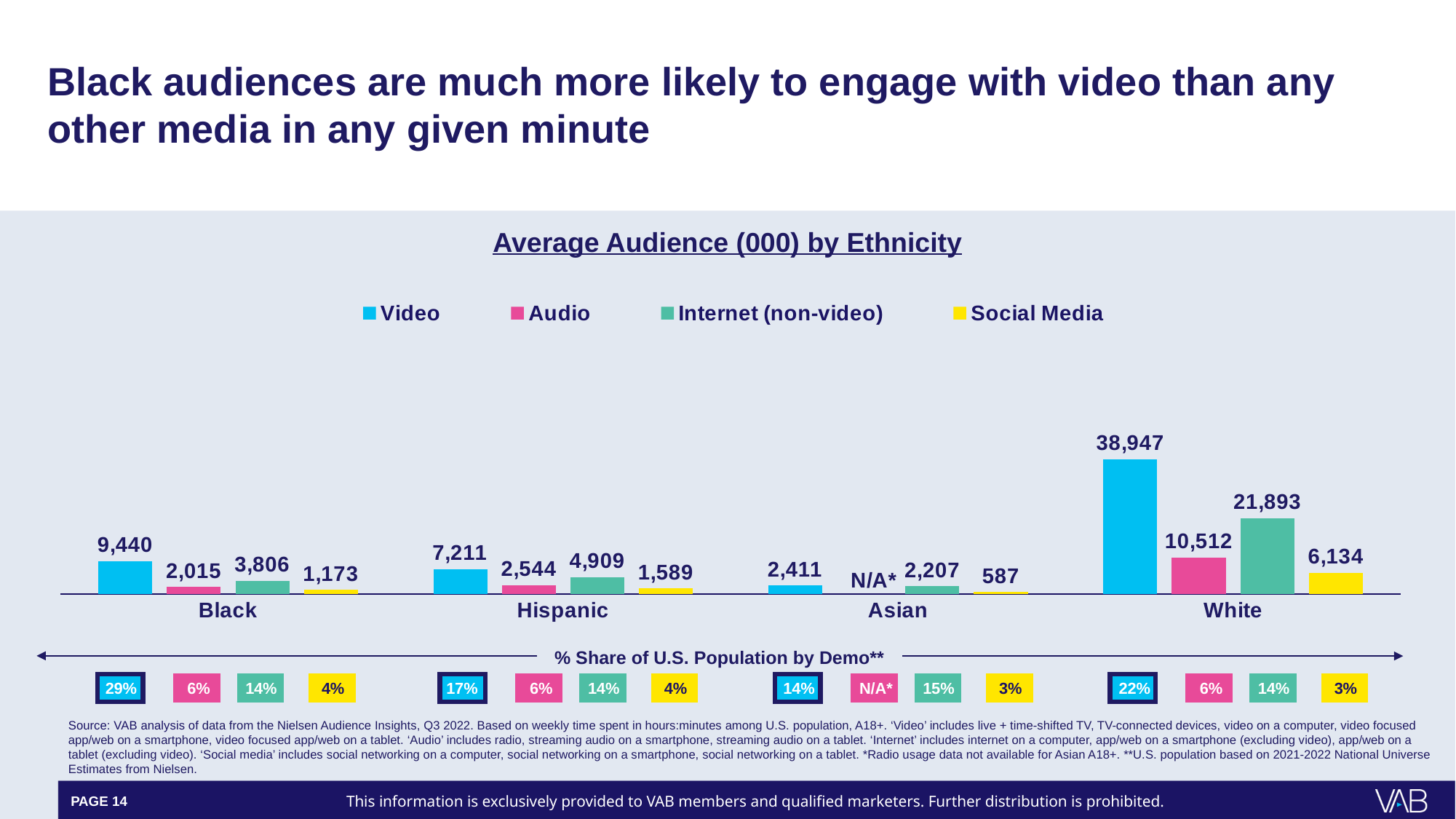
What is shown for the Audio value for Asian audiences? N/A* What is the Audio value for Hispanic audiences? 2,544 What is the Social Media value for Asian audiences? 587 Which ethnicity has the lowest Social Media value? Asian What type of chart is shown? Bar chart How many ethnicity categories are shown on the x axis? 4 How many series does the legend list? 4 What is the difference between the Video and Internet (non-video) values for White audiences? 17,054 What is the Video value for Black audiences? 9,440 What is the Internet (non-video) value for White audiences? 21,893 Which ethnicity has the highest Video value? White Which is larger for Hispanic audiences, Audio or Internet (non-video)? Internet (non-video)